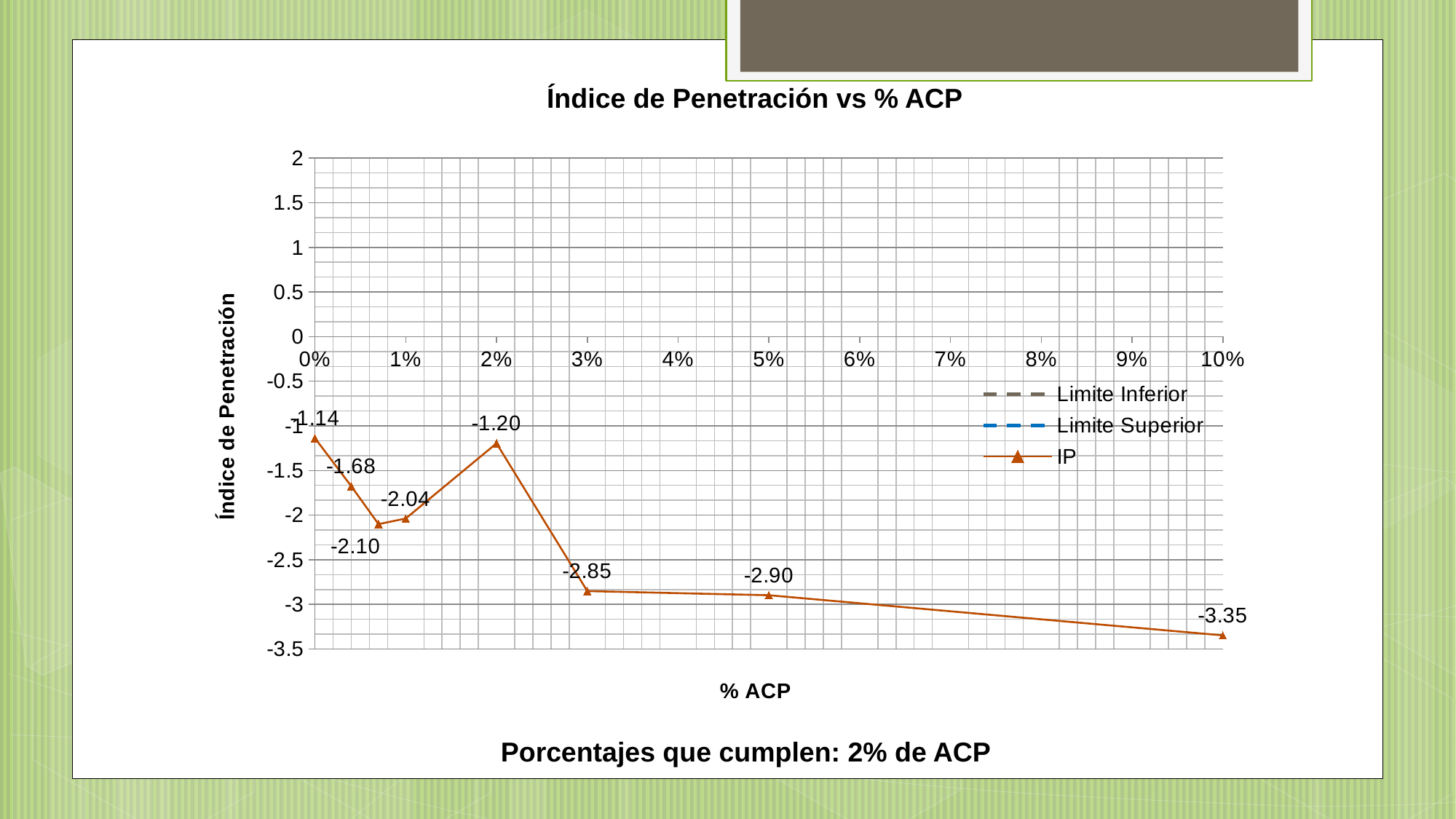
How many data points are plotted on the IP line? 8 How many series does the legend list? 3 At which % ACP is the IP value lowest? 10% Which is larger, the IP value at 3% ACP or at 5% ACP? 3% ACP What is the IP value at 10% ACP? -3.35 What is the IP value at 0% ACP? -1.14 What is the IP value at 2% ACP? -1.20 What is the difference between the IP value at 2% ACP and at 3% ACP? 1.65 What kind of chart is shown on the slide? Line chart At which % ACP is the IP value highest? 0% Does the IP value rise or fall from 3% ACP to 10% ACP? Fall What is the IP value at 5% ACP? -2.90